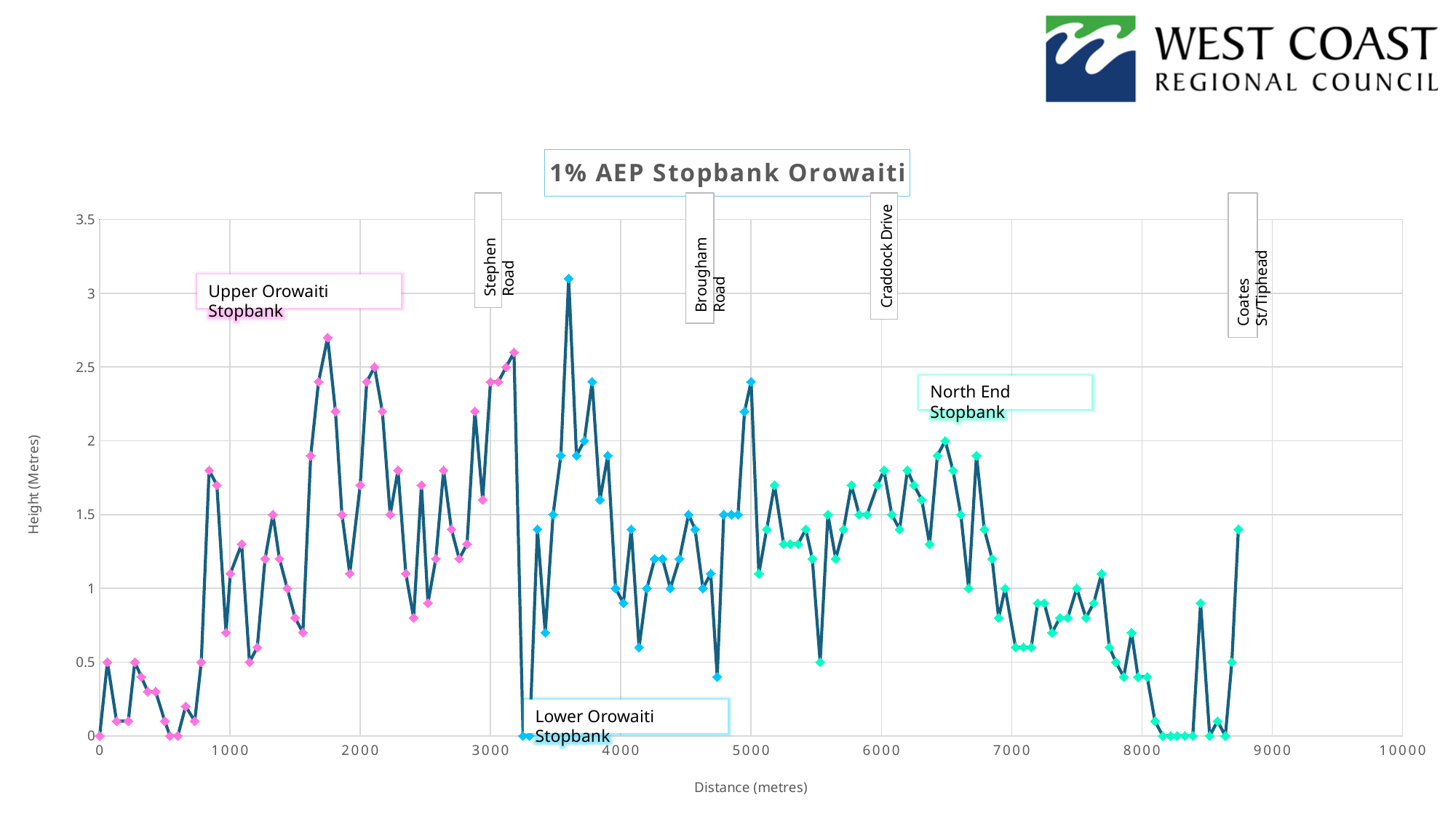
Is the highest point plotted on the chart greater or less than 3? greater Is the height at a distance of 8000 metres greater or less than 1? less Between 7000 and 8000 metres, do the plotted heights generally rise or fall? fall Is the height at a distance of 1000 metres greater or less than 1.5? less Which stopbank section is labelled with pink markers on the chart? Upper Orowaiti Stopbank What kind of chart is shown on the slide? line chart What is the title of the chart? 1% AEP Stopbank Orowaiti What is the lowest height value plotted on the chart? 0